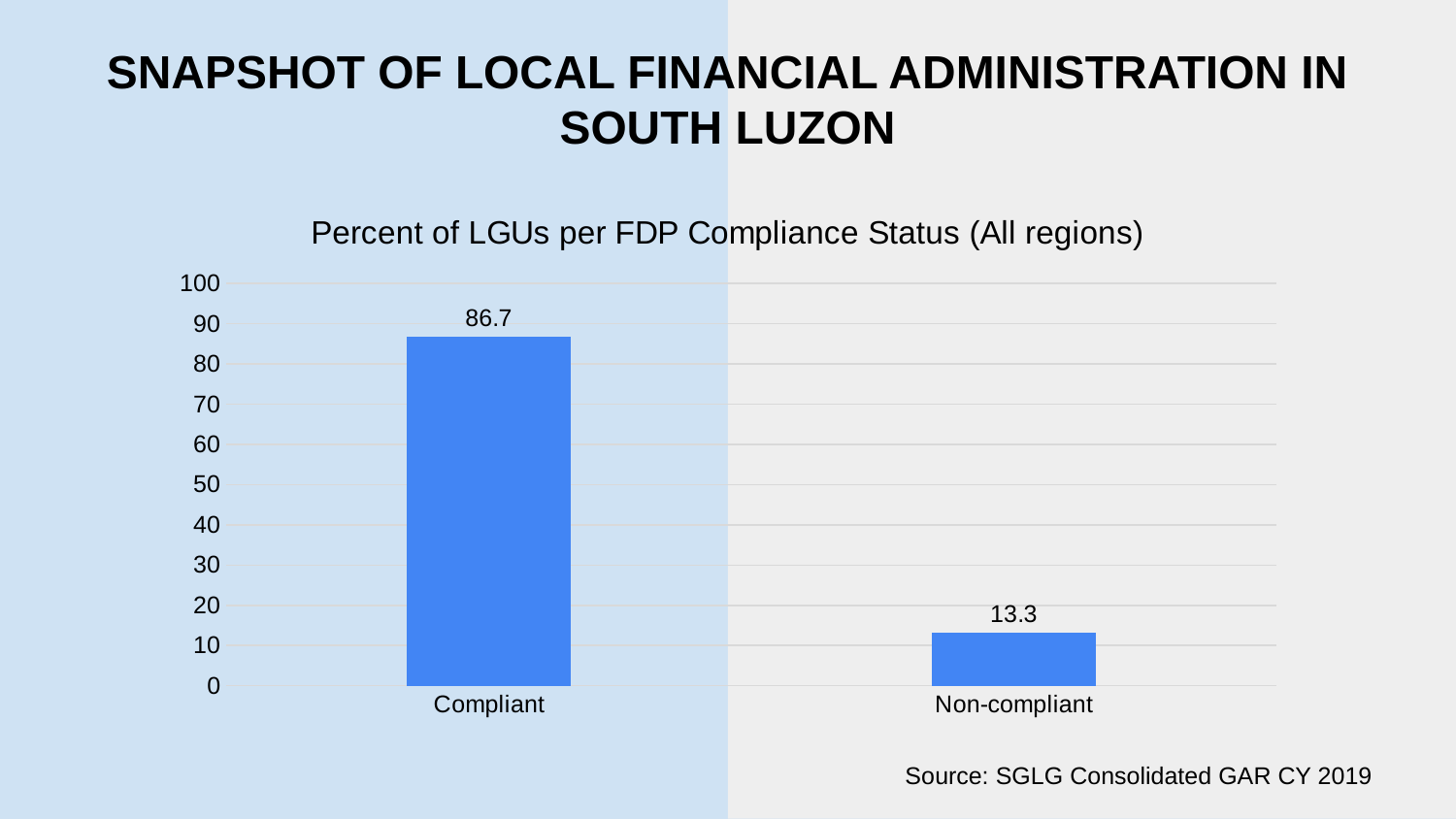
What is the value for Non-compliant? 13.3 Which is larger, the value for Compliant or the value for Non-compliant? Compliant Is the value for Non-compliant greater or less than 20? less How many categories are shown on the chart? 2 What is the value for Compliant? 86.7 What is the source cited for the chart data? SGLG Consolidated GAR CY 2019 What is the difference between the values for Compliant and Non-compliant? 73.4 What is the title of the chart? Percent of LGUs per FDP Compliance Status (All regions) What kind of chart is shown on the slide? bar chart Which category has the lowest value? Non-compliant Is the value for Compliant greater or less than 80? greater Which category has the highest value? Compliant